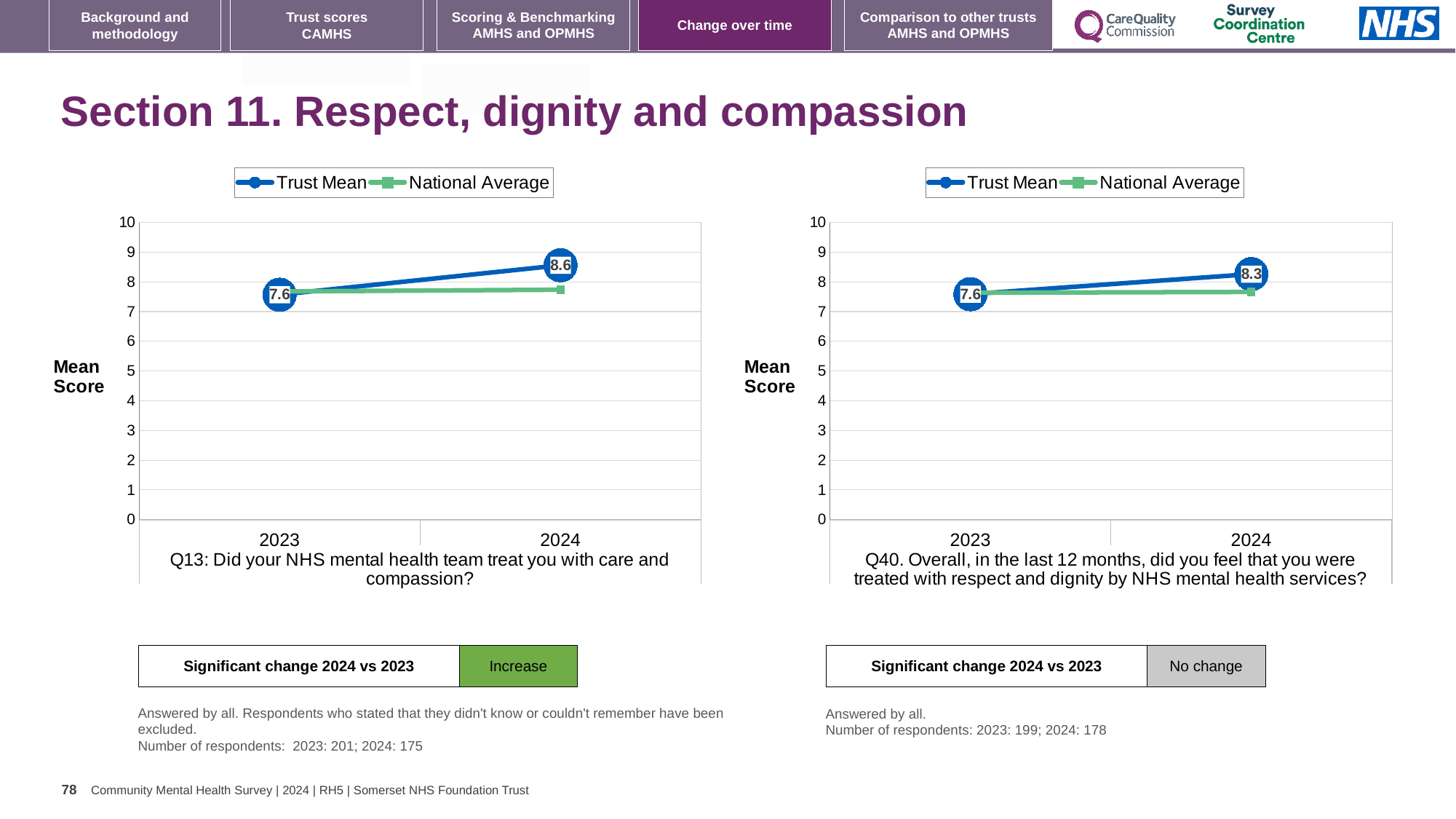
In the Q13 chart on the left, by how much did the Trust Mean change from 2023 to 2024? 1.0 In the Q40 chart on the right, which is larger in 2024, the Trust Mean or the National Average? Trust Mean How many years are shown on the x axis of the Q40 chart on the right? 2 In the Q13 chart on the left, does the Trust Mean rise or fall from 2023 to 2024? rise In the Q40 chart on the right, by how much did the Trust Mean change from 2023 to 2024? 0.7 In the Q13 chart on the left, is the National Average for 2024 greater or less than 8? less In the Q13 chart on the left, what is the Trust Mean score for 2023? 7.6 In the Q13 chart on the left, what is the Trust Mean score for 2024? 8.6 How many series does the legend of the Q40 chart on the right list? 2 What kind of chart is the Q13 chart on the left? line chart In the Q40 chart on the right, what is the Trust Mean score for 2023? 7.6 In the Q40 chart on the right, what is the Trust Mean score for 2024? 8.3